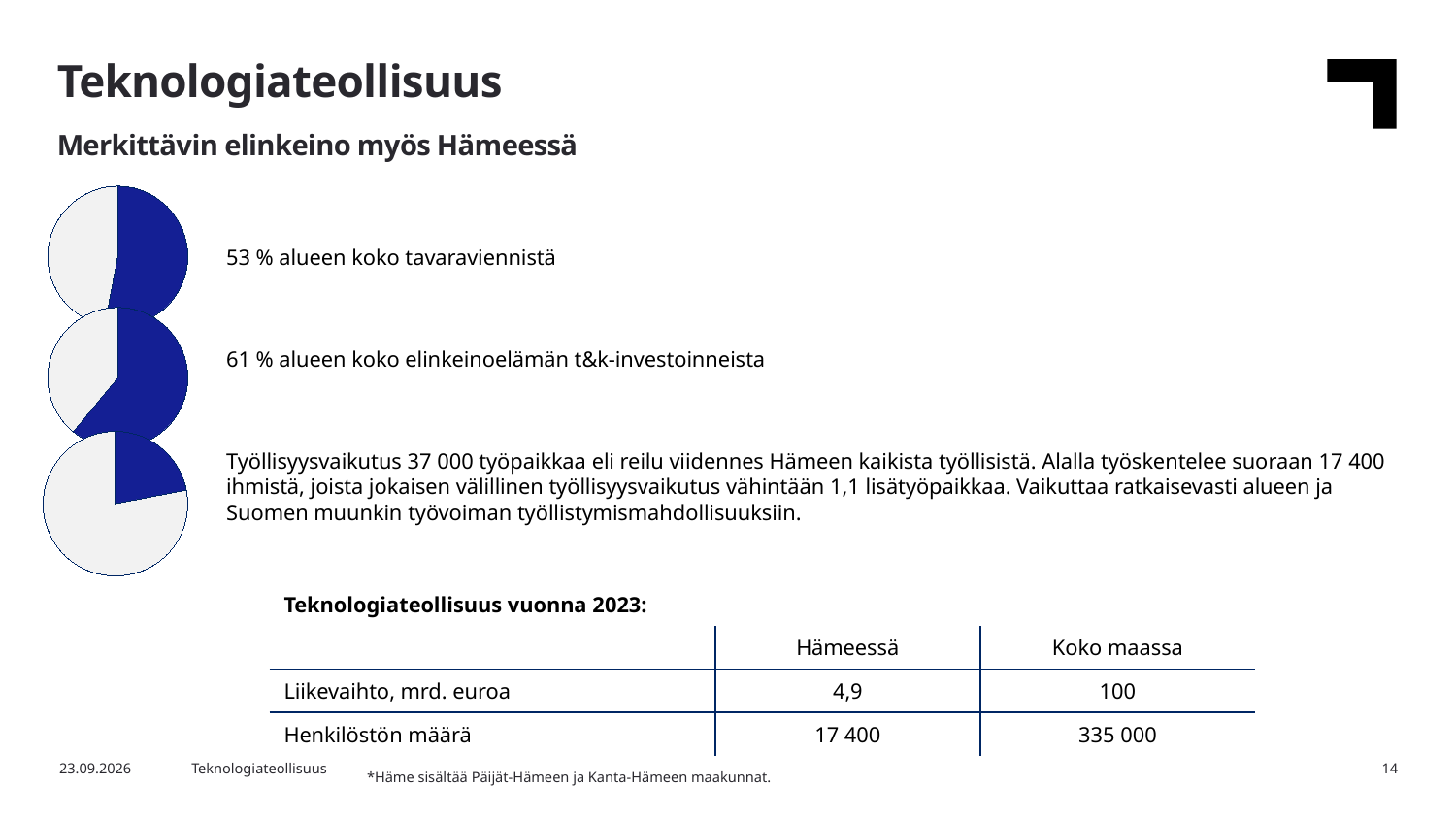
Which pie chart has the smallest highlighted slice: the top, middle or bottom one? Bottom In the top pie chart, what share of the region's total goods exports (tavaravienti) does the highlighted slice represent? 53 % How many pie charts are on the slide? 3 What is the difference in percentage points between the share shown for the middle pie chart (61 %) and the top pie chart (53 %)? 8 percentage points In the middle pie chart, what share of the region's business R&D investments (t&k-investoinnit) does the highlighted slice represent? 61 % Which pie chart has the largest highlighted slice: the top, middle or bottom one? Middle Is the highlighted slice in the middle pie chart larger or smaller than the highlighted slice in the top pie chart? Larger What colour is the highlighted slice in the pie charts? Dark blue What kind of charts are shown on the left side of the slide? Pie charts Is the highlighted slice in the bottom pie chart greater or less than half of the pie? less How many slices does each pie chart have? 2